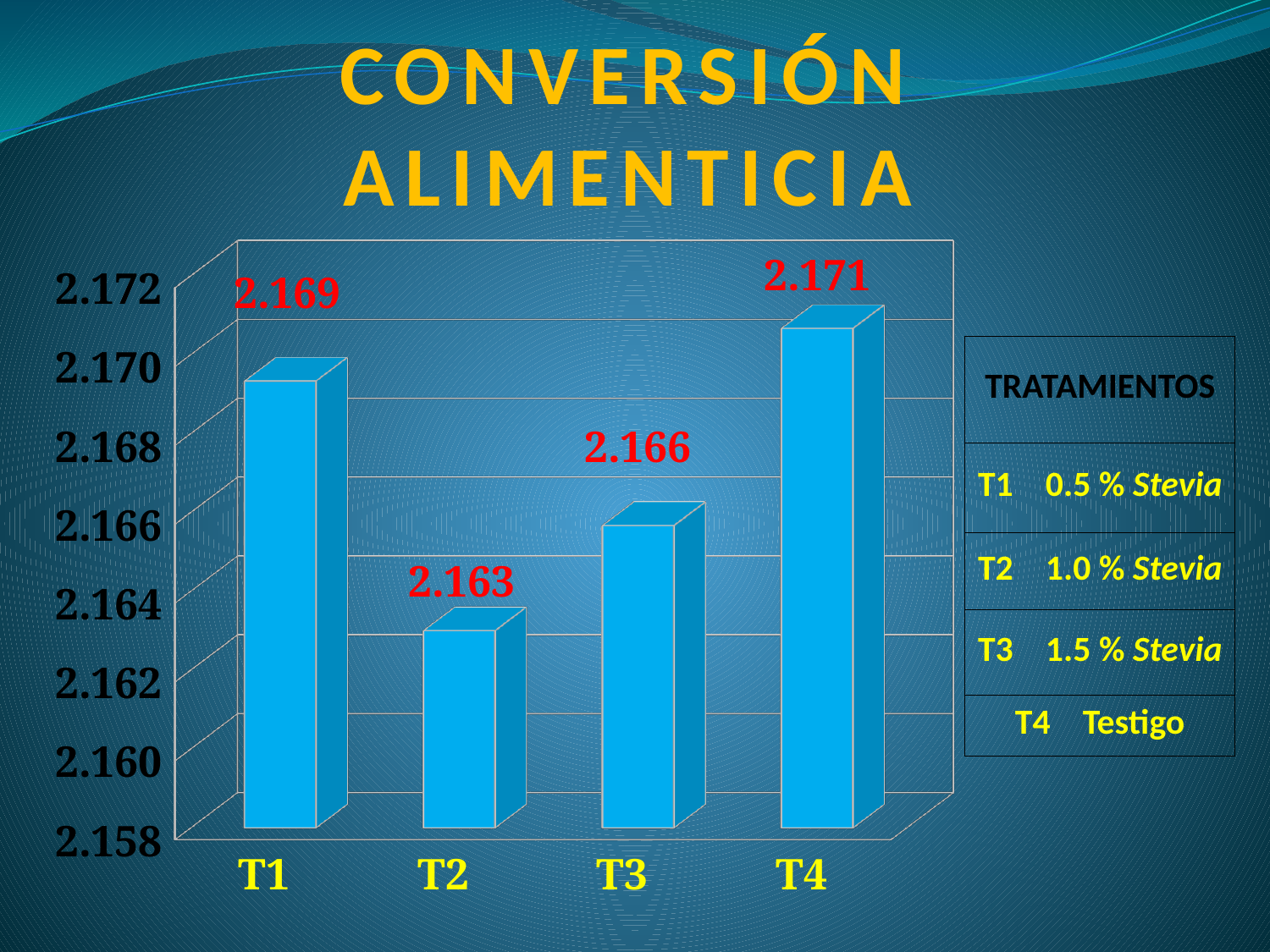
What is the difference between the values for T4 and T2? 0.008 What is the value for T2? 2.163 Which treatment has the highest value? T4 How many treatments are shown on the x axis? 4 What is the value for T4? 2.171 What is the value for T3? 2.166 What is the value for T1? 2.169 Which treatment has the lowest value? T2 What is the difference between the values for T1 and T3? 0.003 According to the legend table, what does T4 represent? Testigo What kind of chart is shown on the slide? bar chart Which is larger, the value for T1 or the value for T3? T1